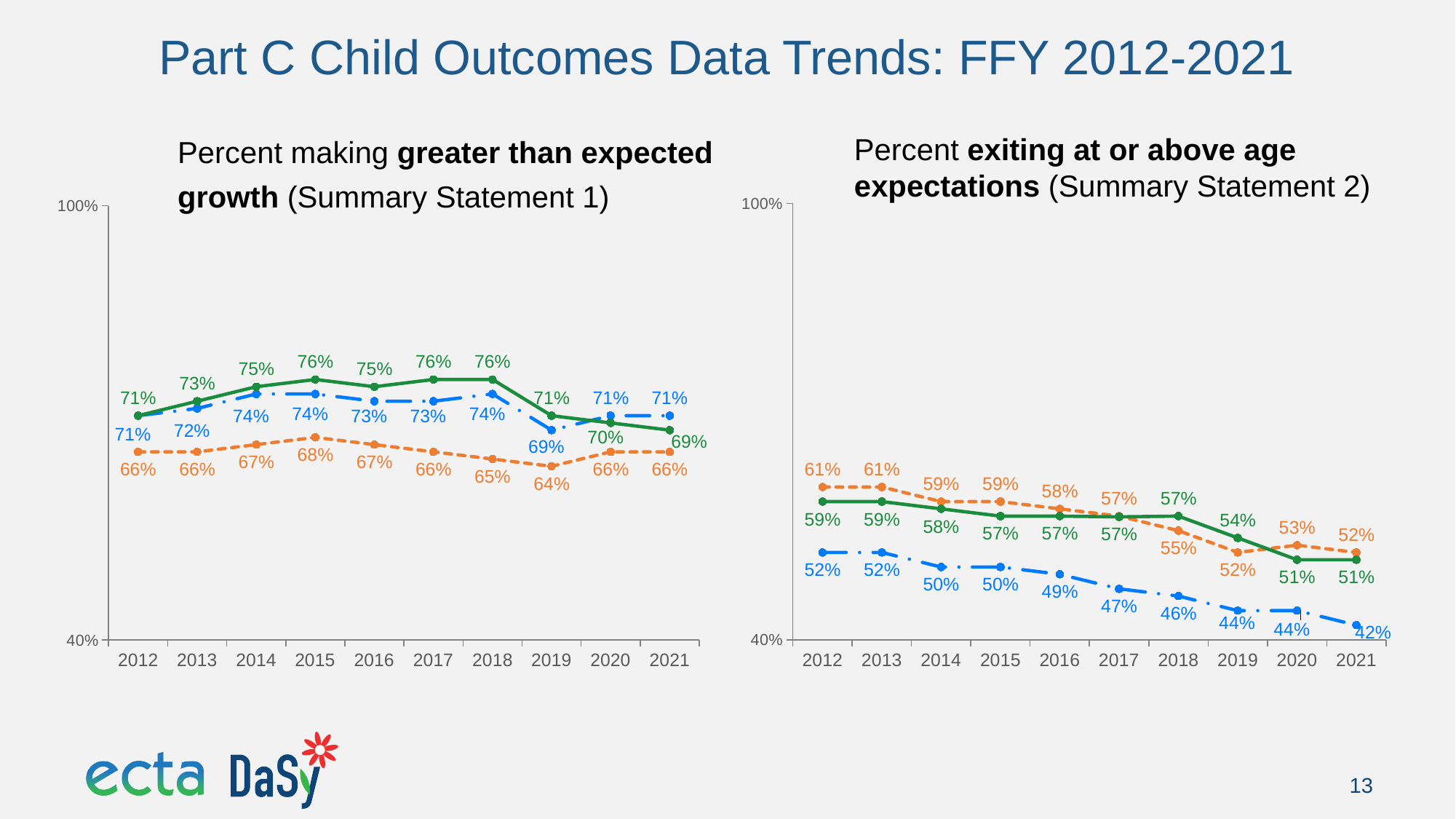
In the left chart (Summary Statement 1), what is the value of the orange dashed line in 2019? 64% In the right chart (Summary Statement 2), what is the difference between the green line's value in 2012 and its value in 2021? 8 percentage points How many lines are plotted in the right chart (Summary Statement 2)? 3 What type of chart is used on this slide for both Summary Statement 1 and Summary Statement 2? Line chart In the left chart (Summary Statement 1), what is the difference between the green line and the blue line in 2018? 2 percentage points In the left chart (Summary Statement 1), which is higher in 2019: the green line or the orange line? The green line In the left chart (Summary Statement 1), what is the value of the green solid line in 2015? 76% In the right chart (Summary Statement 2), what is the value of the blue dash-dot line in 2021? 42% In the right chart (Summary Statement 2), in which year is the blue dash-dot line at its lowest? 2021 In the left chart (Summary Statement 1), how many years are shown on the x axis? 10 In the right chart (Summary Statement 2), does the blue dash-dot line generally rise or fall from 2012 to 2021? Fall In the left chart (Summary Statement 1), in which year is the orange dashed line at its lowest? 2019